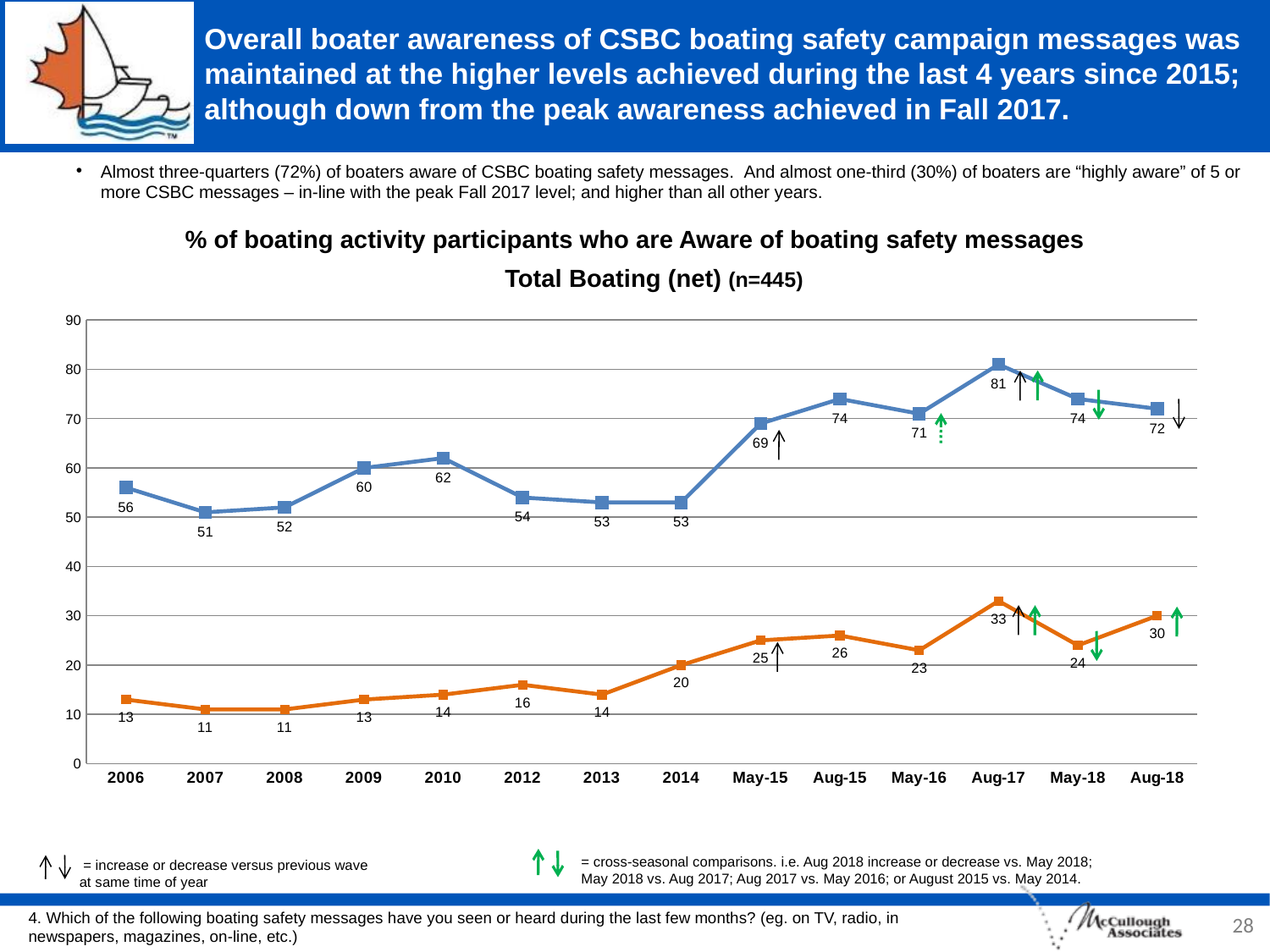
What is the sample size (n) shown in the chart subtitle? n=445 What is the difference between the orange line's Aug-17 value and its May-18 value? 9 Which is larger on the blue line: the value for 2009 or the value for 2012? 2009 In which period does the blue (upper) line reach its highest value? Aug-17 What is the difference between the blue line's Aug-17 value and its Aug-18 value? 9 What is the value of the blue (upper) line for Aug-17? 81 What type of chart is shown on the slide? line chart What is the value of the blue (upper) line for 2010? 62 Does the blue (upper) line rise or fall from May-16 to Aug-17? rise What is the lowest value shown on the orange (lower) line? 11 What is the value of the orange (lower) line for Aug-18? 30 How many time periods are plotted along the x axis? 14